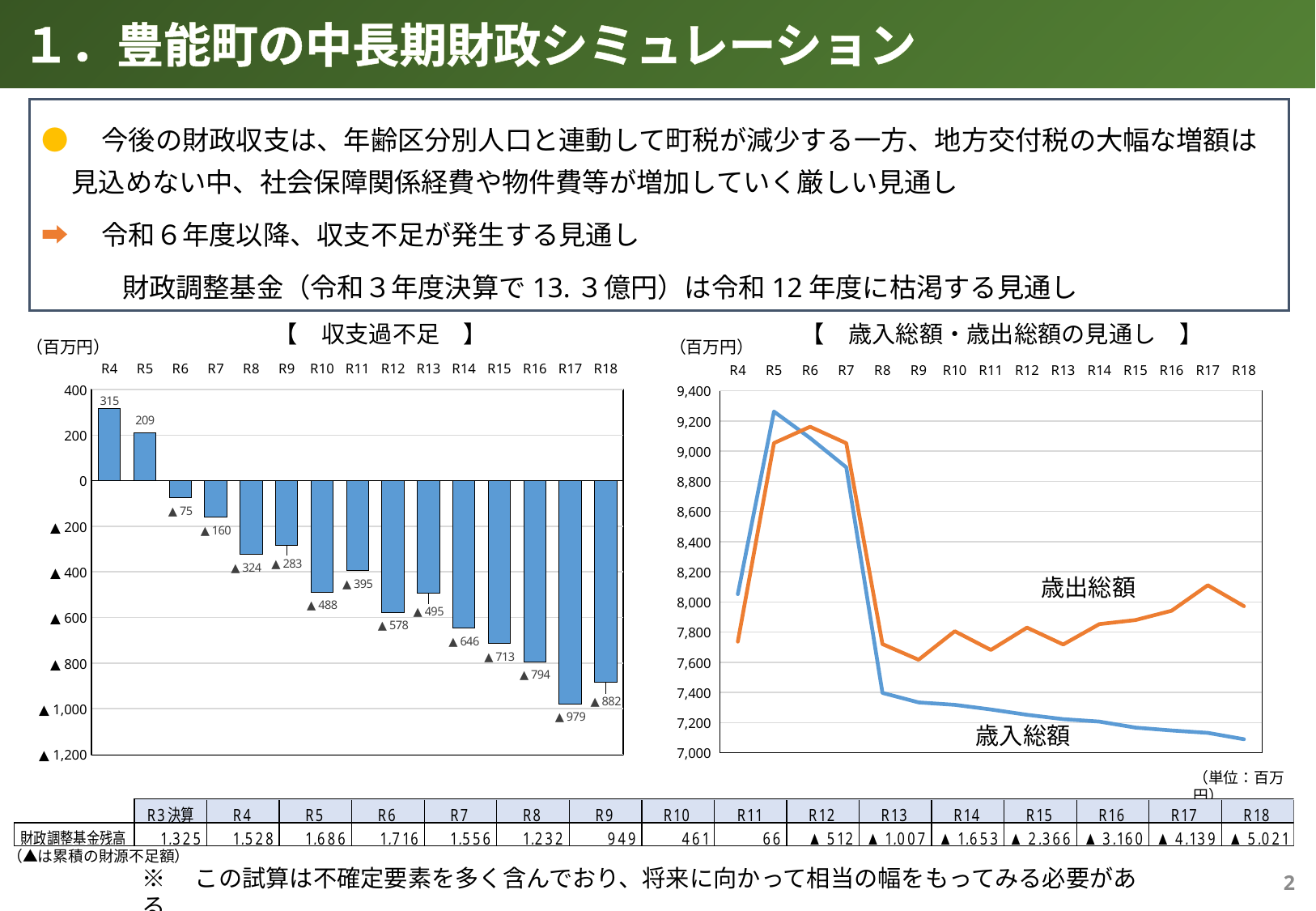
In the 収支過不足 bar chart, which year shows the larger deficit, R10 or R11? R10 In the 歳入総額・歳出総額の見通し chart, is the value of 歳入総額 at R18 greater or less than 7,200? less What kind of chart is the 収支過不足 chart on the left? Bar chart In the 収支過不足 bar chart, which year has the lowest value (largest deficit)? R17 In the 歳入総額・歳出総額の見通し chart, does 歳入総額 rise or fall from R8 to R18? Fall In the 収支過不足 bar chart, what is the value for R17? ▲979 In the 収支過不足 bar chart, what is the difference between the values for R4 and R5? 106 In the 収支過不足 bar chart, which year has the highest value? R4 In the 収支過不足 bar chart, what is the value for R12? ▲578 In the 収支過不足 bar chart, what is the value for R4? 315 How many years are plotted in the 収支過不足 bar chart? 15 How many series are plotted in the 歳入総額・歳出総額の見通し chart on the right? 2